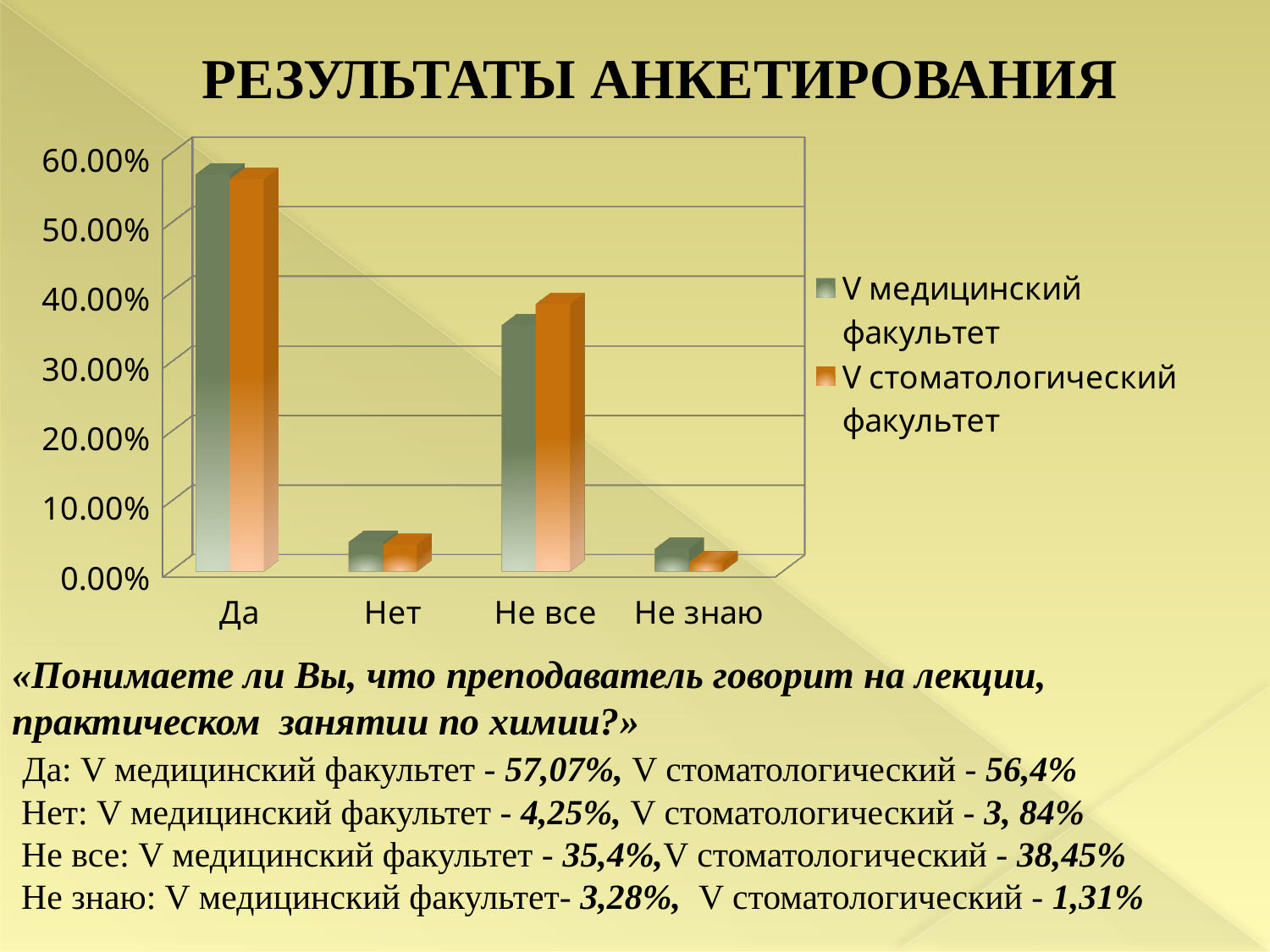
How many categories are shown on the x axis? 4 Is the value for "Да" for V стоматологический факультет greater or less than 50.00%? greater What is the value for "Не знаю" for V медицинский факультет? 3,28% For "Не все", which series has the larger value: V медицинский факультет or V стоматологический факультет? V стоматологический факультет How many series does the legend list? 2 Which category has the highest value for V стоматологический факультет? Да What is the title of the slide above the chart? РЕЗУЛЬТАТЫ АНКЕТИРОВАНИЯ What is the value for "Не все" for V стоматологический факультет? 38,45% Which category has the lowest value for V медицинский факультет? Не знаю What type of chart is shown on the slide? bar chart What is the value for "Да" for V медицинский факультет? 57,07% What is the difference between the V медицинский факультет and V стоматологический факультет values for "Не знаю"? 1,97%